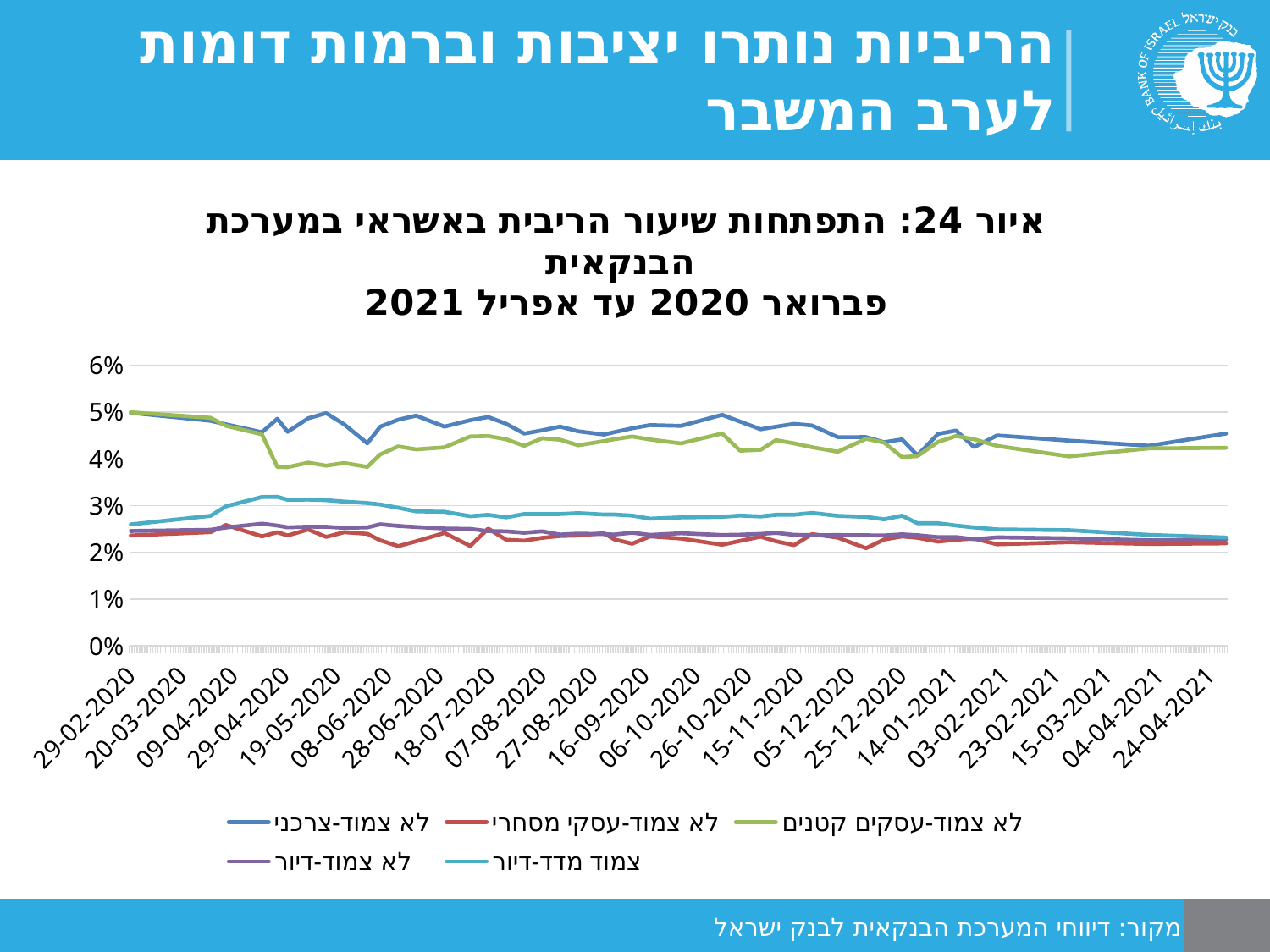
Is the value of the לא צמוד-עסקי מסחרי series at 29-02-2020 greater or less than 3%? less Which is larger at 29-04-2020: the לא צמוד-צרכני series or the לא צמוד-עסקים קטנים series? לא צמוד-צרכני Which is larger at 29-02-2020: the לא צמוד-צרכני series or the לא צמוד-עסקי מסחרי series? לא צמוד-צרכני Is the value of the צמוד מדד-דיור series at 29-04-2020 greater or less than 3%? greater Does the צמוד מדד-דיור series rise or fall between 29-04-2020 and 24-04-2021? Fall Is the value of the לא צמוד-צרכני series at 29-02-2020 greater or less than 4%? greater What kind of chart is shown on the slide? Line chart What is the title of the chart? איור 24: התפתחות שיעור הריבית באשראי במערכת הבנקאית פברואר 2020 עד אפריל 2021 What is the first date label on the x axis? 29-02-2020 How many series does the legend list? 5